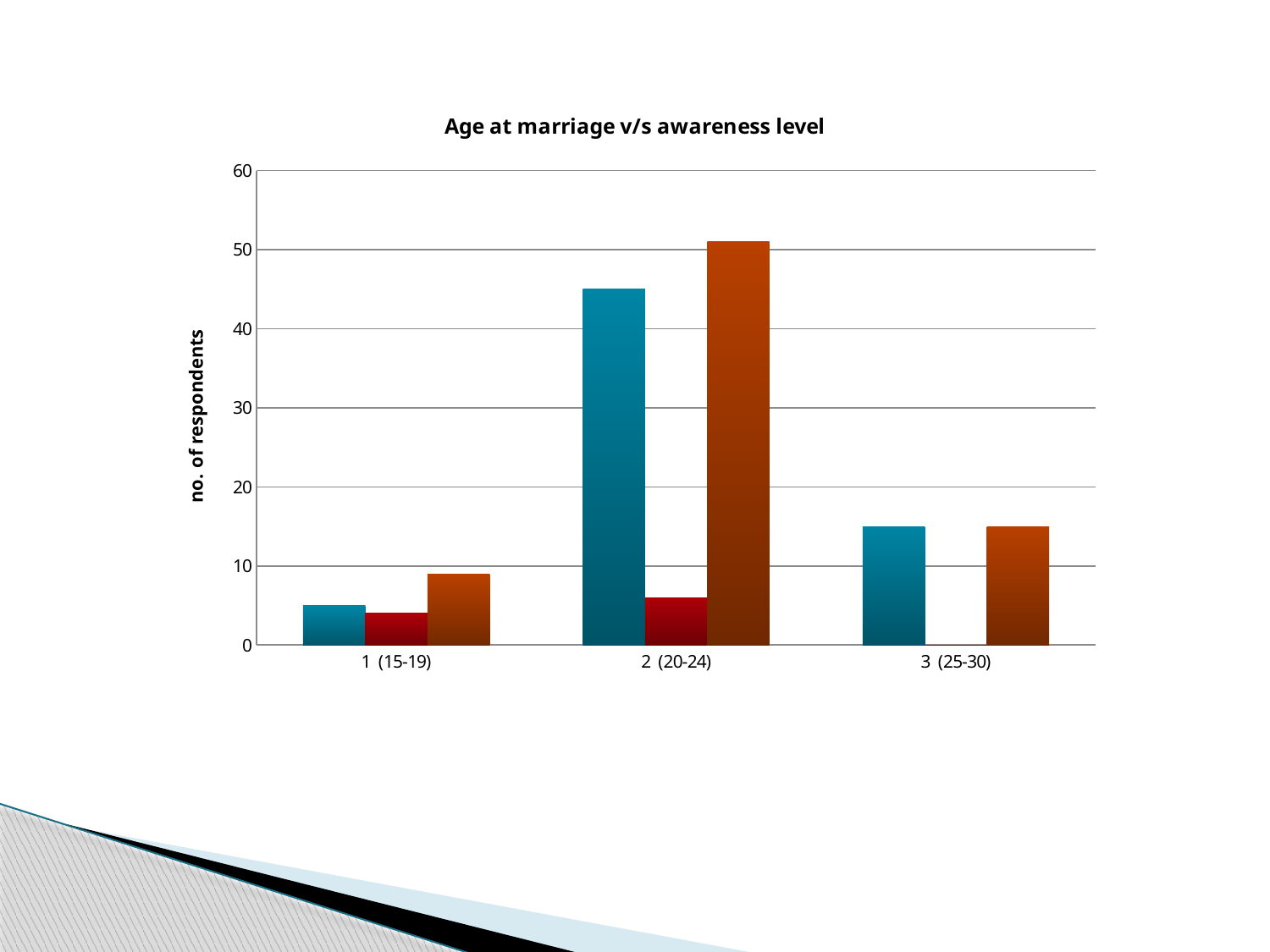
What is the label on the vertical axis of the chart? no. of respondents Is the value of the blue bar for 1 (15-19) greater or less than 10? less Which age-group category has the tallest bar in the chart? 2 (20-24) Is the value of the dark red bar for 2 (20-24) greater or less than 10? less Is the value of the blue bar for 2 (20-24) greater or less than 40? greater What is the title of the chart? Age at marriage v/s awareness level For the 1 (15-19) category, which is larger: the dark red bar or the orange bar? the orange bar How many age-group categories are shown on the x axis? 3 For the 2 (20-24) category, which is larger: the blue bar or the orange bar? the orange bar What kind of chart is shown on the slide? bar chart